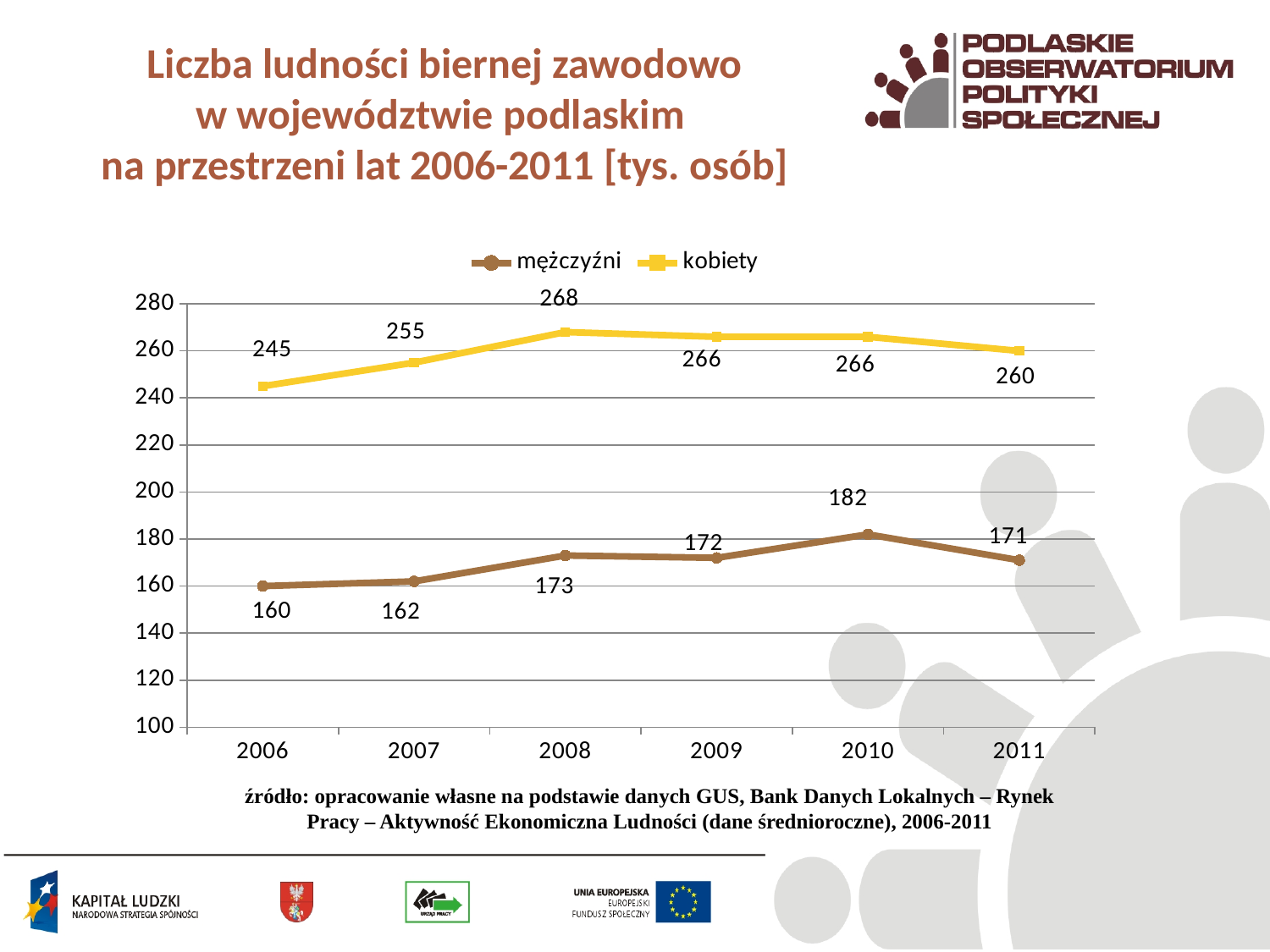
How many series does the legend list? 2 How many years are shown on the x axis? 6 Which is larger: the mężczyźni value in 2008 or in 2009? 2008 What is the value for kobiety in 2008? 268 What is the difference between the kobiety and mężczyźni values in 2011? 89 In which year is the value for kobiety highest? 2008 What is the value for mężczyźni in 2006? 160 What kind of chart is shown on the slide? line chart In which year is the value for mężczyźni lowest? 2006 Is the value for kobiety in 2006 greater or less than 240? greater What is the value for mężczyźni in 2010? 182 Does the mężczyźni series rise or fall from 2006 to 2010? rise